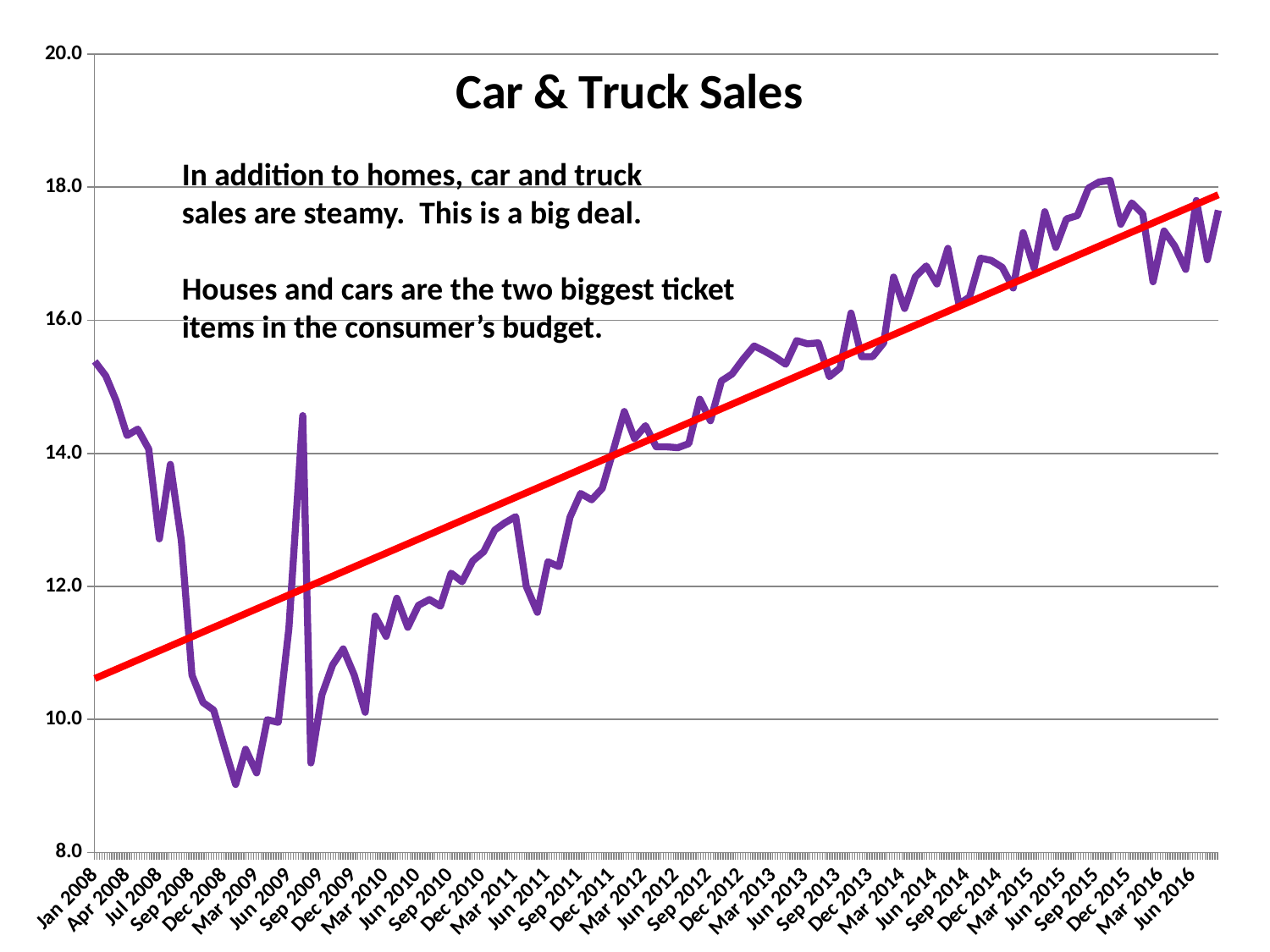
What is the title of the chart? Car & Truck Sales Is the value of the purple line at Mar 2013 greater or less than 14.0? greater Does the red trend line rise or fall from left to right across the chart? rise Does the purple line rise or fall between Jan 2008 and Dec 2008? fall Which is larger, the value of the purple line at Dec 2008 or at Dec 2012? Dec 2012 Is the value of the purple line at Jan 2008 greater or less than 14.0? greater Does the purple line generally rise or fall between Mar 2010 and Jun 2016? rise What kind of chart is shown on the slide? line chart What colour is the straight trend line drawn across the chart? red Is the value of the purple line at Jun 2016 greater or less than 16.0? greater Which is larger, the value of the purple line at Jan 2008 or at Jun 2016? Jun 2016